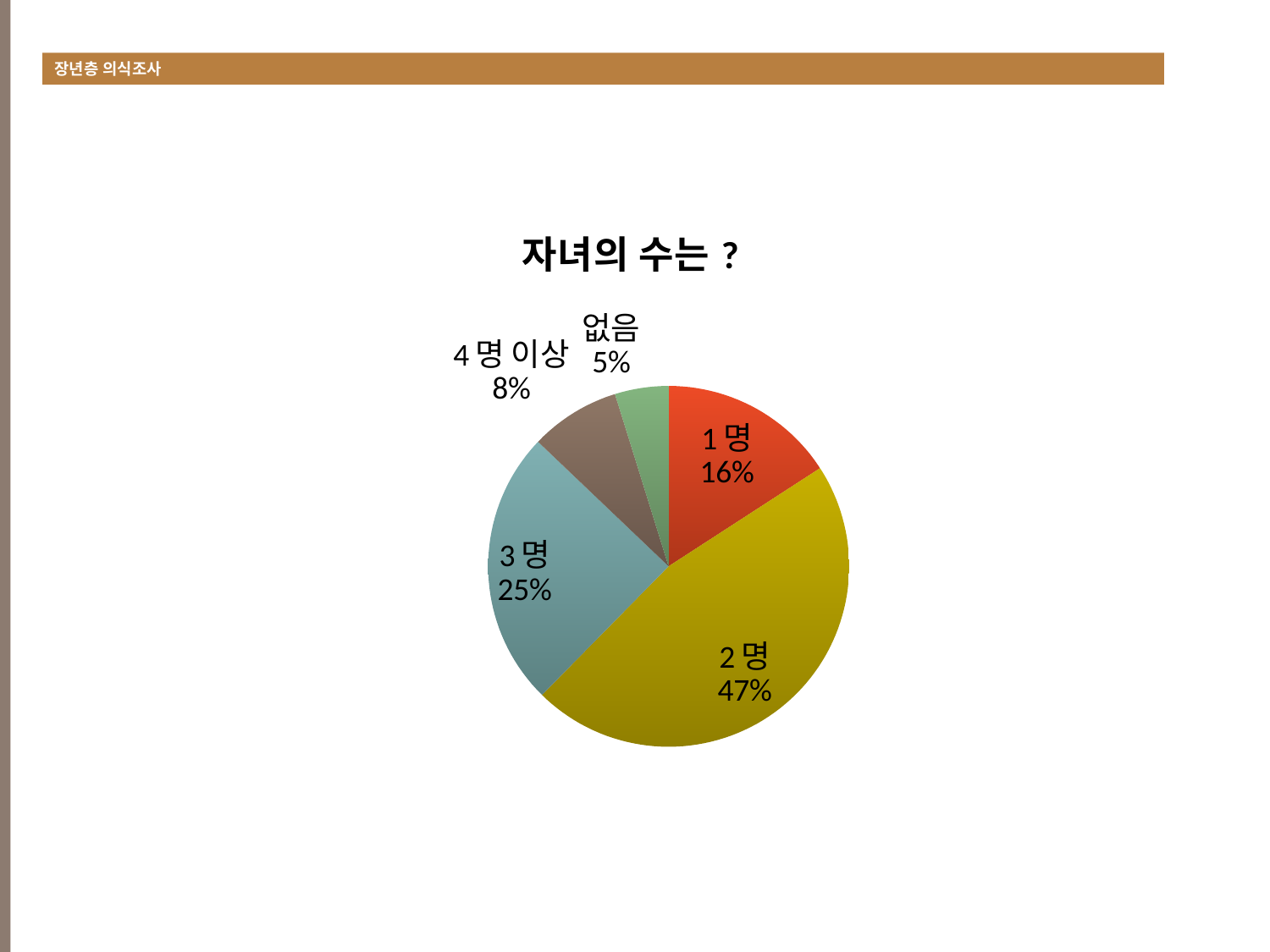
What is the title of the chart? 자녀의 수는 ? What is the value shown for 1 명? 16% What share of the pie does the 2 명 slice represent? 47% Which category has the smallest slice of the pie? 없음 Which is larger, the share for 1 명 or the share for 4 명 이상? 1 명 What is the value shown for 3 명? 25% What is the difference between the shares for 2 명 and 3 명? 22% How many categories are shown in the pie chart? 5 What is the value shown for 4 명 이상? 8% Which category has the largest slice of the pie? 2 명 What type of chart is shown on the slide? pie chart What is the value shown for 없음? 5%